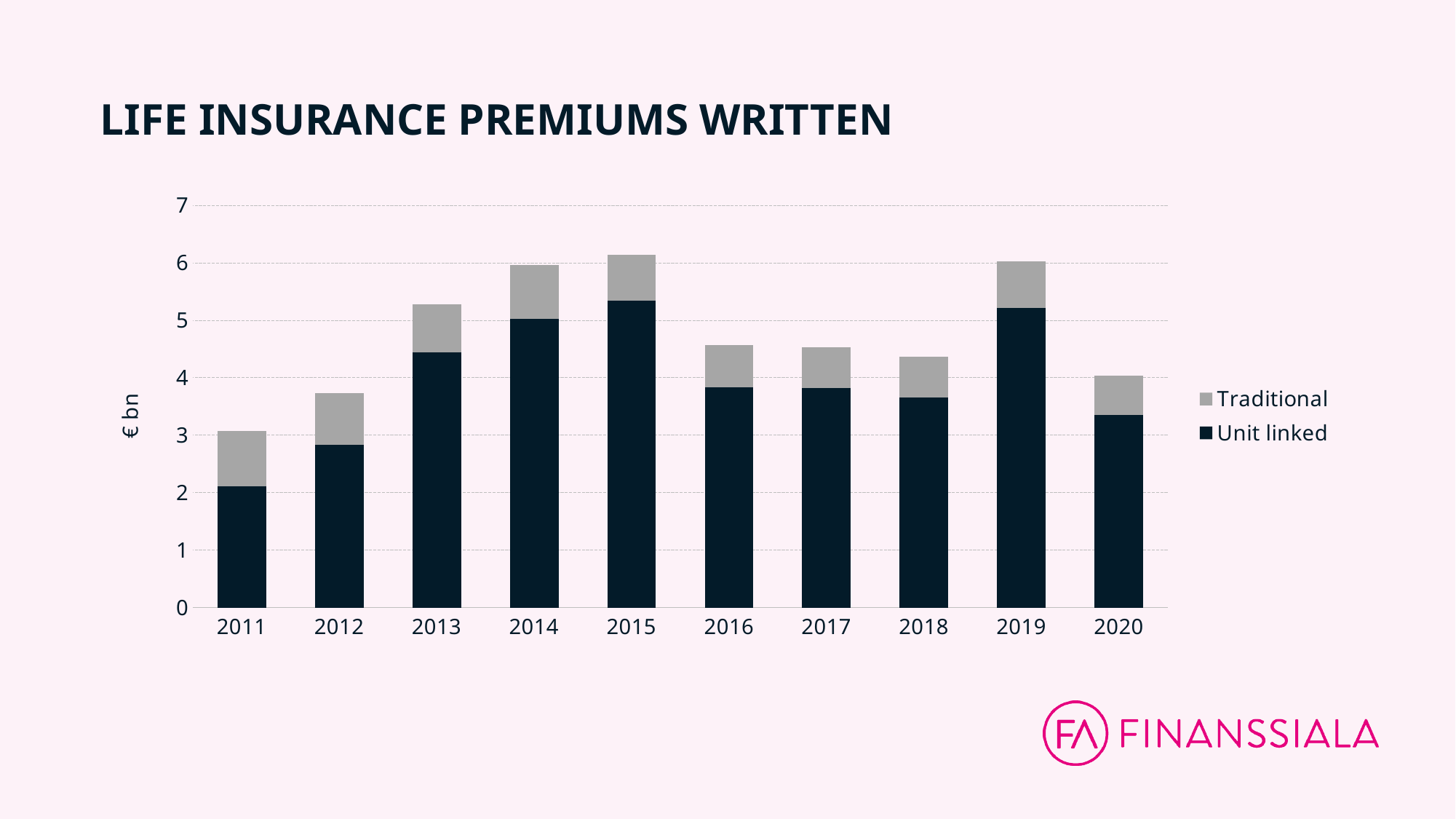
Is the total value for 2020 greater or less than 5? less Is the total value for 2014 greater or less than 5? greater What is the label on the y axis of the chart? € bn What kind of chart is shown on the slide? Stacked bar chart Which year has the lowest total life insurance premiums written? 2011 Do the total premiums rise or fall from 2011 to 2015? rise How many series does the legend list? 2 Which is larger, the total for 2013 or the total for 2016? 2013 Is the Unit linked value for 2016 greater or less than 4? less Which year has the highest total life insurance premiums written? 2015 How many years are shown on the x axis of the chart? 10